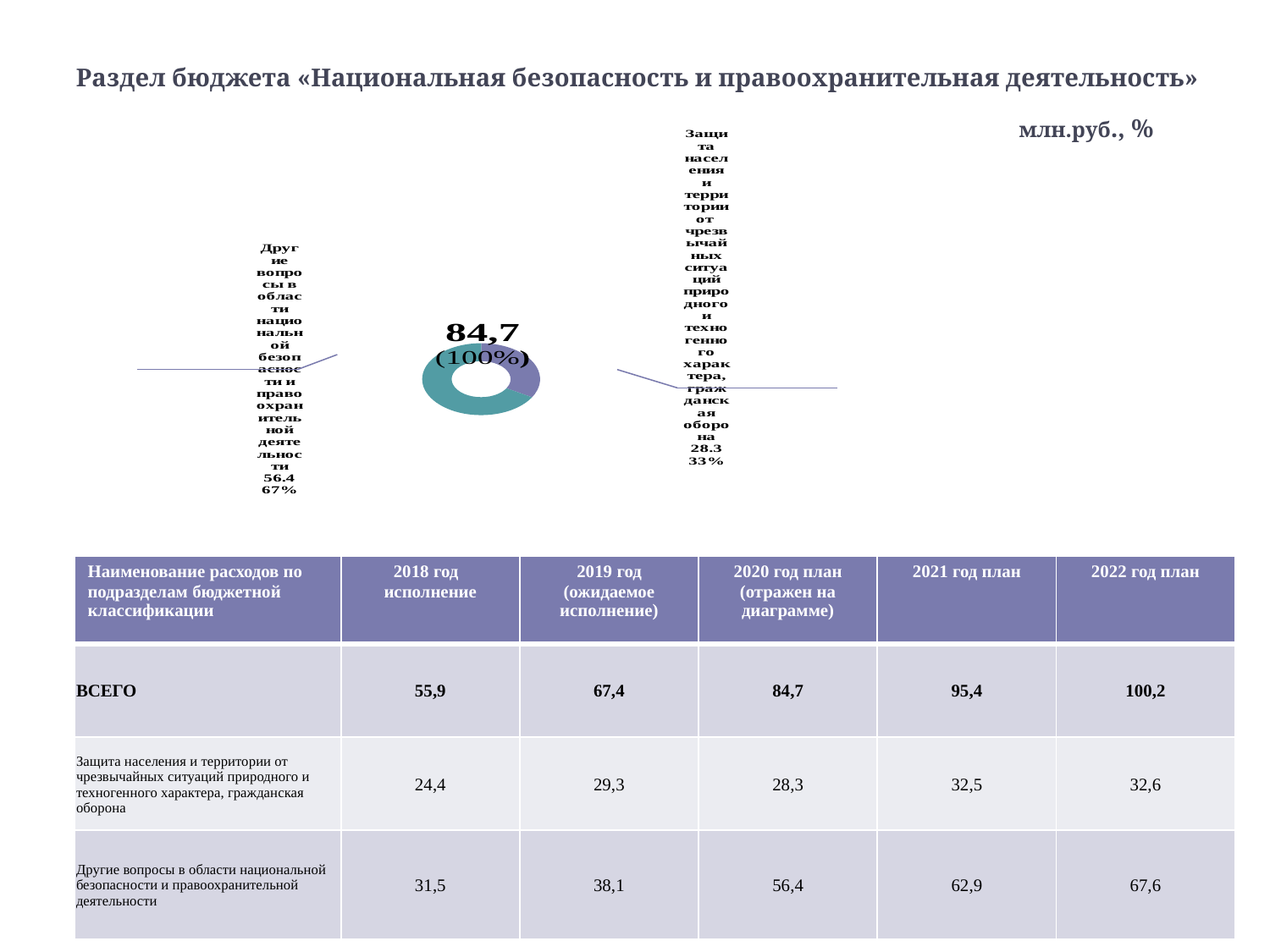
What units are indicated for the chart on the slide? млн.руб., % What total value is printed in the centre of the doughnut chart? 84,7 (100%) What percentage share does the slice 'Защита населения и территории от чрезвычайных ситуаций природного и техногенного характера, гражданская оборона' have? 33% How many slices does the doughnut chart have? 2 What kind of chart is shown on the slide? Doughnut (pie) chart Which slice of the doughnut chart is the largest? Другие вопросы в области национальной безопасности и правоохранительной деятельности What value is shown for the slice 'Другие вопросы в области национальной безопасности и правоохранительной деятельности'? 56.4 What value is shown for the slice 'Защита населения и территории от чрезвычайных ситуаций природного и техногенного характера, гражданская оборона'? 28.3 Which is larger: the slice for 'Другие вопросы...' or the slice for 'Защита населения...'? Другие вопросы в области национальной безопасности и правоохранительной деятельности Which slice of the doughnut chart is the smallest? Защита населения и территории от чрезвычайных ситуаций природного и техногенного характера, гражданская оборона What is the difference between the values of the two slices, 56.4 and 28.3? 28.1 What percentage share does the slice 'Другие вопросы в области национальной безопасности и правоохранительной деятельности' have? 67%